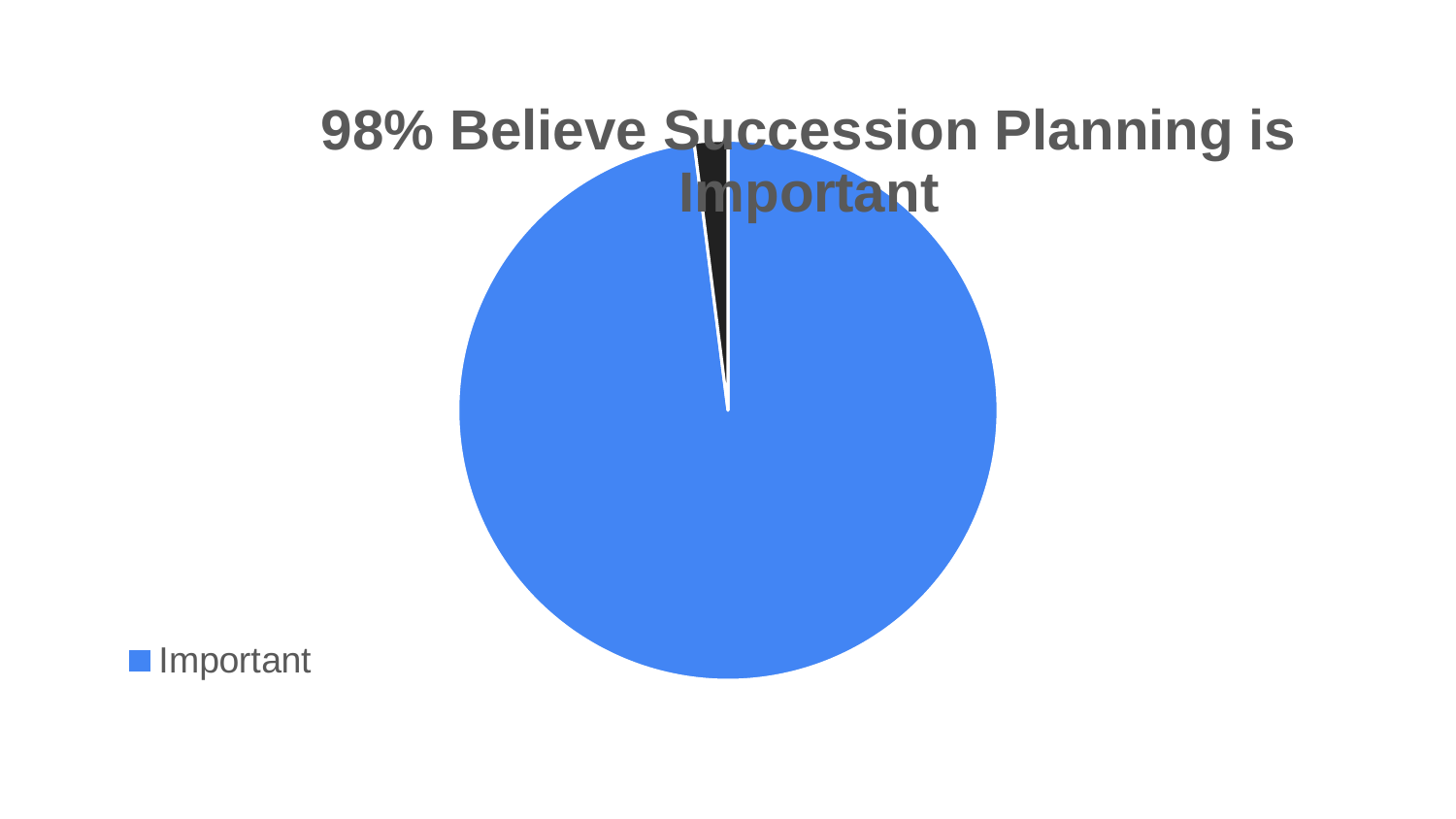
According to the slide, what share of the pie does the 'Important' slice represent? 98% What kind of chart is shown on the slide? pie chart What is the title of the chart? 98% Believe Succession Planning is Important Which slice of the pie is the largest? Important Is the 'Important' slice larger or smaller than the black slice? larger How many slices does the pie chart have? 2 Is the share for 'Important' greater or less than 50%? greater What is the only category named in the legend? Important How many entries does the chart's legend list? 1